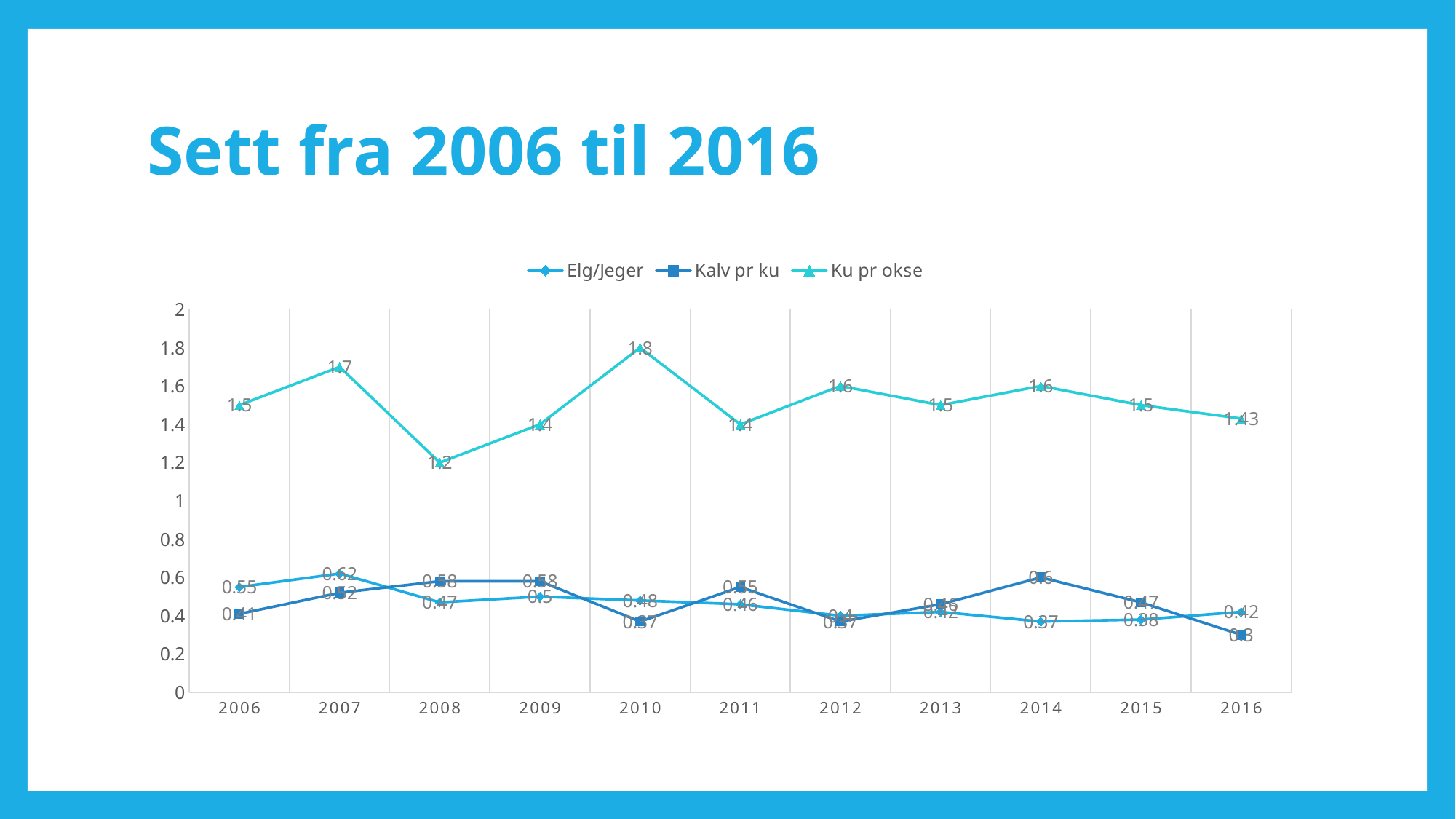
What is the value of Ku pr okse in 2010? 1.8 What is the value of Ku pr okse in 2016? 1.43 In which year is Ku pr okse highest? 2010 What kind of chart is shown on the slide? line chart In which year is Ku pr okse lowest? 2008 What is the value of Ku pr okse in 2008? 1.2 What is the difference between the Ku pr okse values in 2010 and 2008? 0.6 How many series does the legend list? 3 Which year has the larger Ku pr okse value, 2007 or 2009? 2007 What is the value of Elg/Jeger in 2007? 0.62 How many years are plotted along the x axis? 11 What is the title of the slide? Sett fra 2006 til 2016